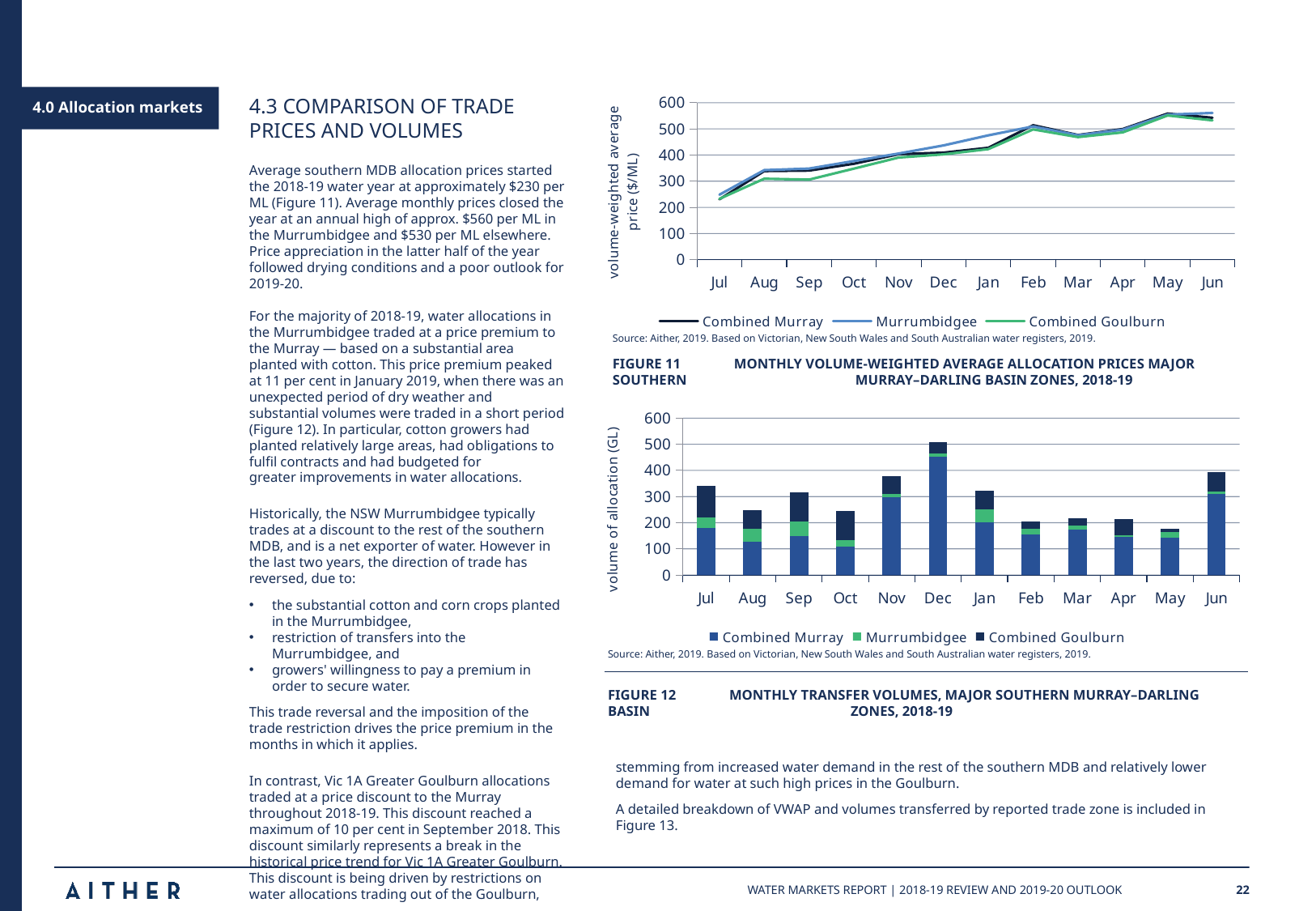
What kind of chart is Figure 11, Monthly volume-weighted average allocation prices? Line chart What kind of chart is Figure 12, Monthly transfer volumes? Bar chart In Figure 11, do the allocation prices generally rise or fall from Jul to Jun? Rise In Figure 12, which month has the highest total transfer volume? Dec In Figure 12, is the Combined Murray volume in Dec greater or less than 400? greater In Figure 11, is the Murrumbidgee price in Jul greater or less than 300? less In Figure 12, which month has the lowest total transfer volume? May In Figure 12, how many months are shown on the x axis? 12 In Figure 11, how many series does the legend list? 3 In Figure 11, is the Murrumbidgee price in Jun greater or less than 500? greater In Figure 11, in which month is the Combined Murray price lowest? Jul In Figure 12, which is larger, the total volume in Dec or the total volume in Jun? Dec